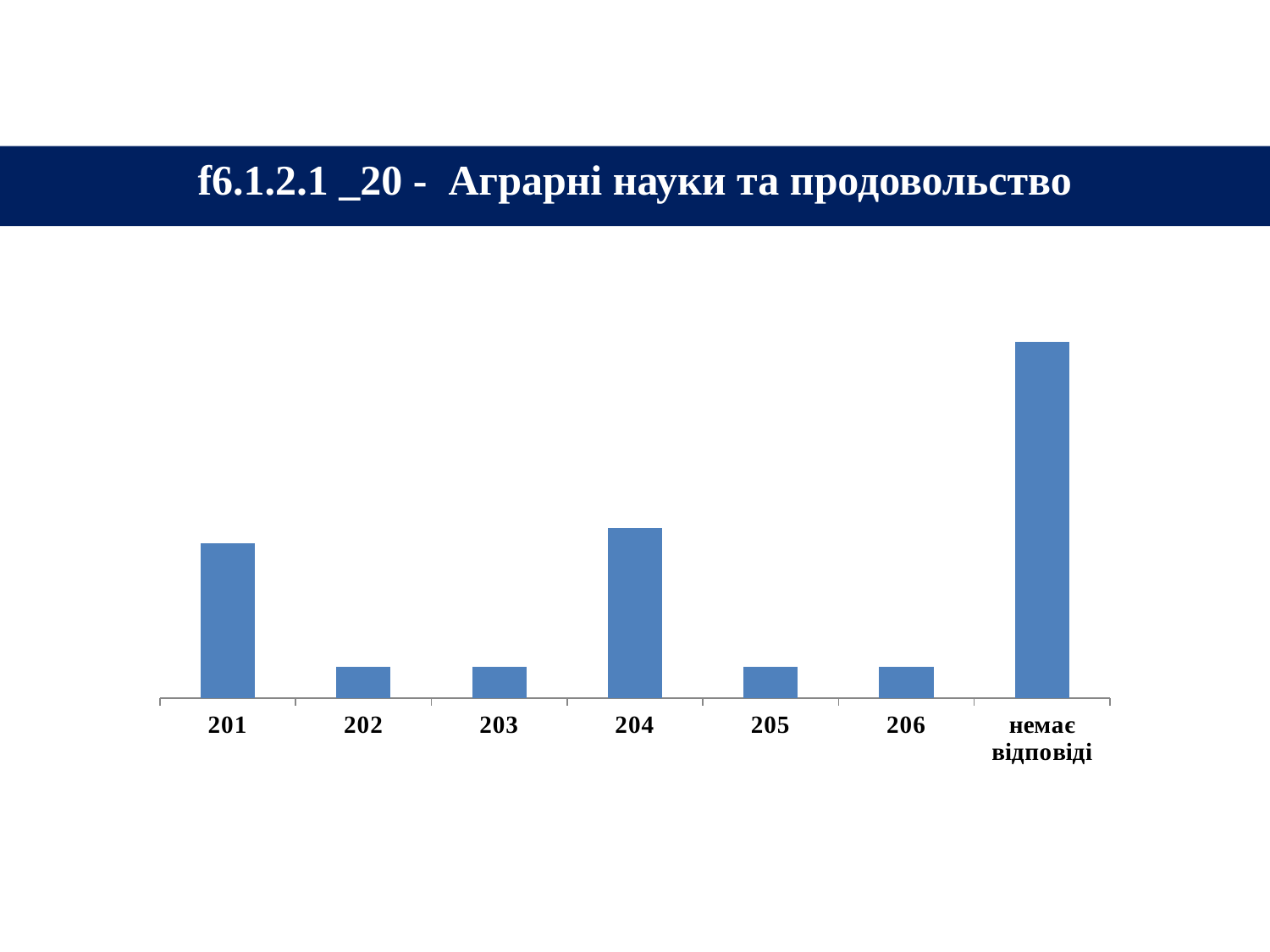
How many categories are shown on the x axis? 7 Which is larger, the value for 201 or the value for 202? 201 Which is larger, the value for 203 or the value for 204? 204 What is the title shown above the chart? f6.1.2.1 _20 - Аграрні науки та продовольство Which is larger, the value for 204 or the value for 205? 204 What kind of chart is shown on the slide? bar chart What colour are the bars in the chart? blue Which category has the highest bar? немає відповіді